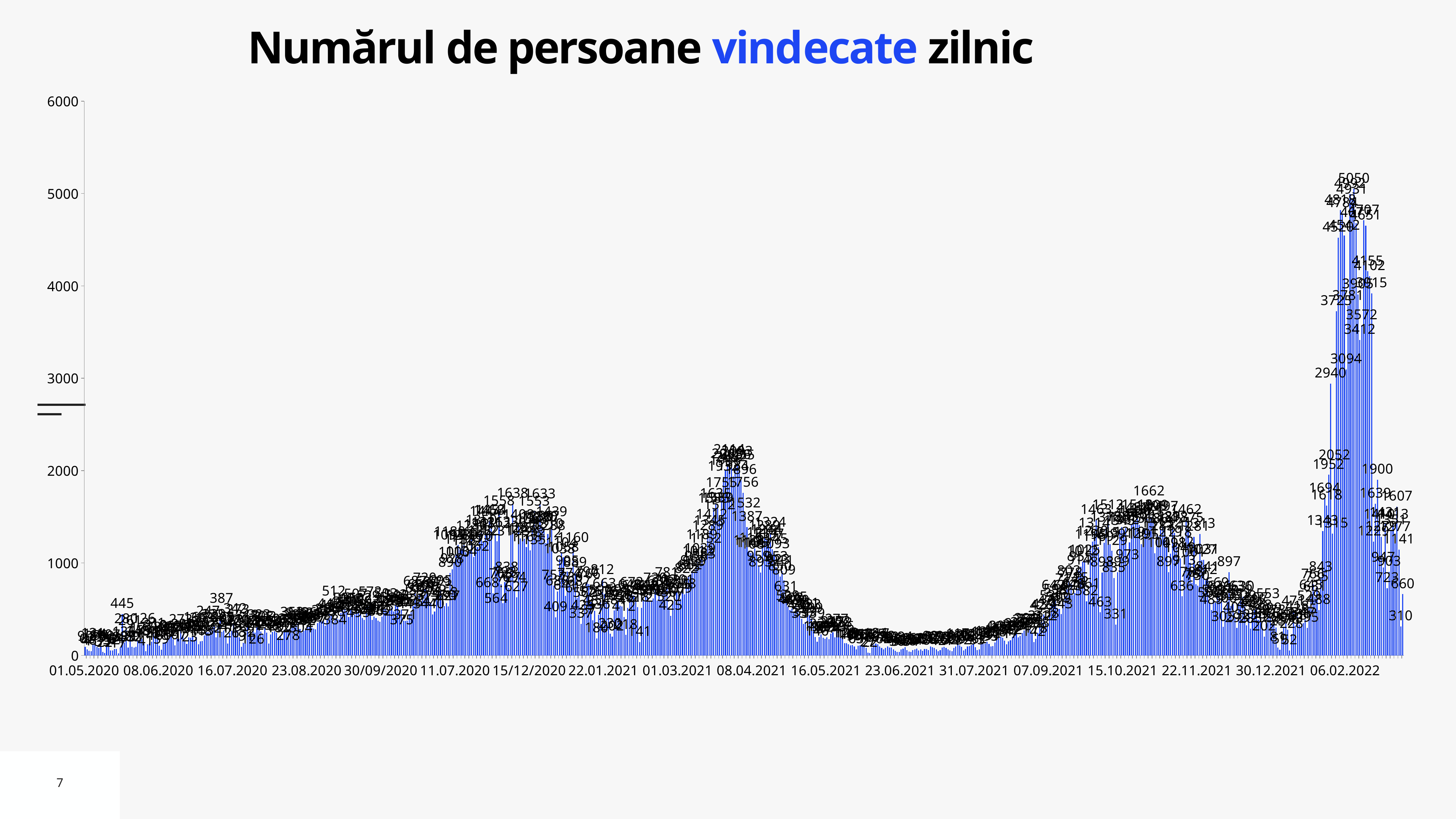
What kind of chart is shown on the slide? bar chart Do the values rise or fall between 16.05.2021 and 23.06.2021? fall What is the title of the chart? Numărul de persoane vindecate zilnic Which peak is higher: the one around 08.04.2021 or the one around 06.02.2022? 06.02.2022 Is the highest value on the chart greater or less than 5000? greater What is the maximum value shown on the y axis? 6000 Is the value at 01.05.2020 greater or less than 1000? less Is the peak value around 08.04.2021 greater or less than 3000? less Do the values rise or fall between 07.09.2021 and 15.10.2021? rise What is the highest daily value labelled on the chart? 5050 What is the first date shown on the x axis? 01.05.2020